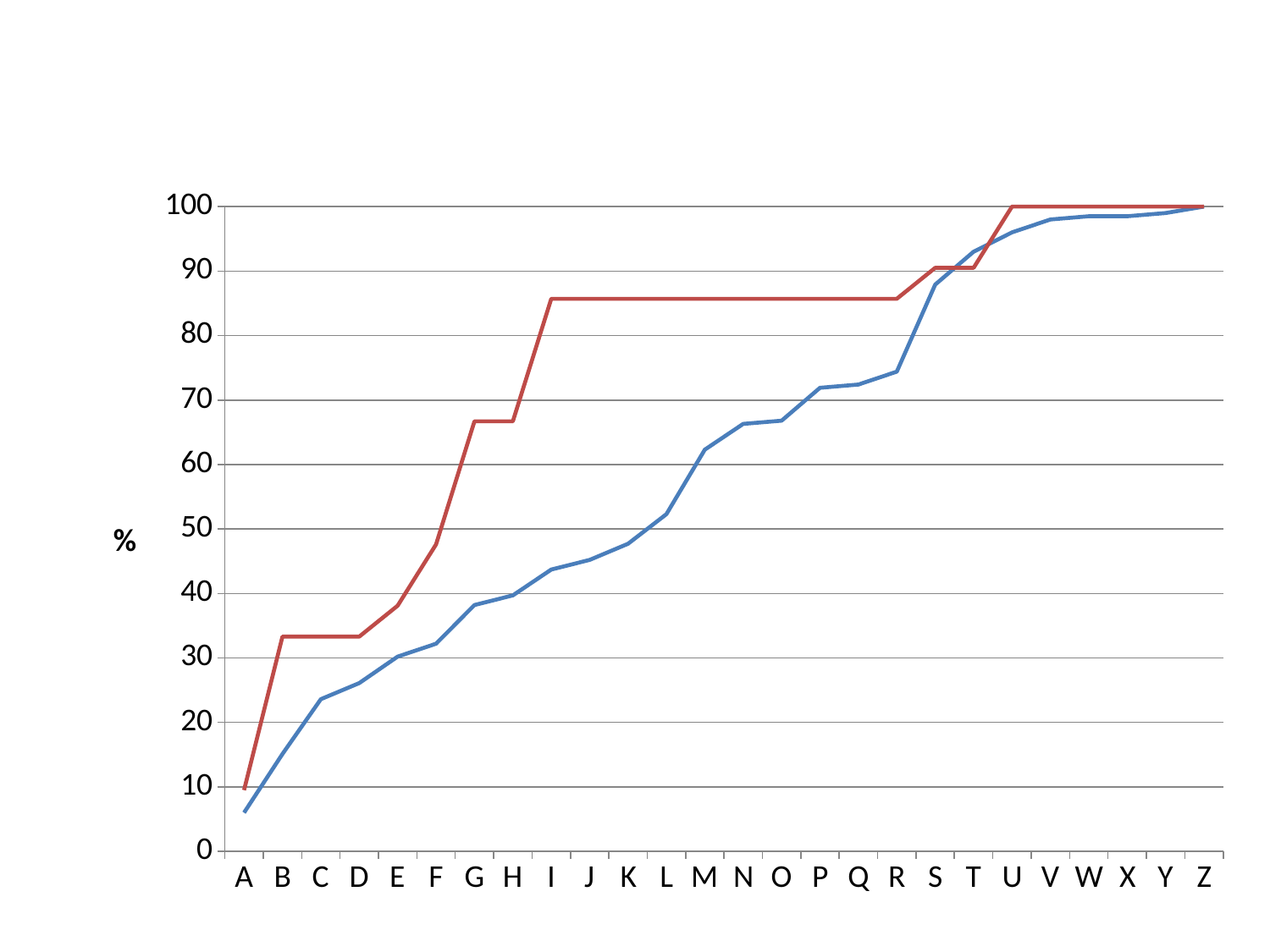
How many lines (series) are plotted on the chart? 2 What kind of chart is shown on the slide? line chart Is the value of the blue line at A greater or less than 10? less Is the value of the red line at G greater or less than 70? less At category I, which line has the higher value, the red line or the blue line? the red line What is the label on the y axis? % How many categories are shown on the x axis? 26 What value does the red line reach at category U? 100 What value does the blue line reach at category Z? 100 Is the value of the blue line at R greater or less than 70? greater Do the values of the blue line rise or fall from A to Z? rise